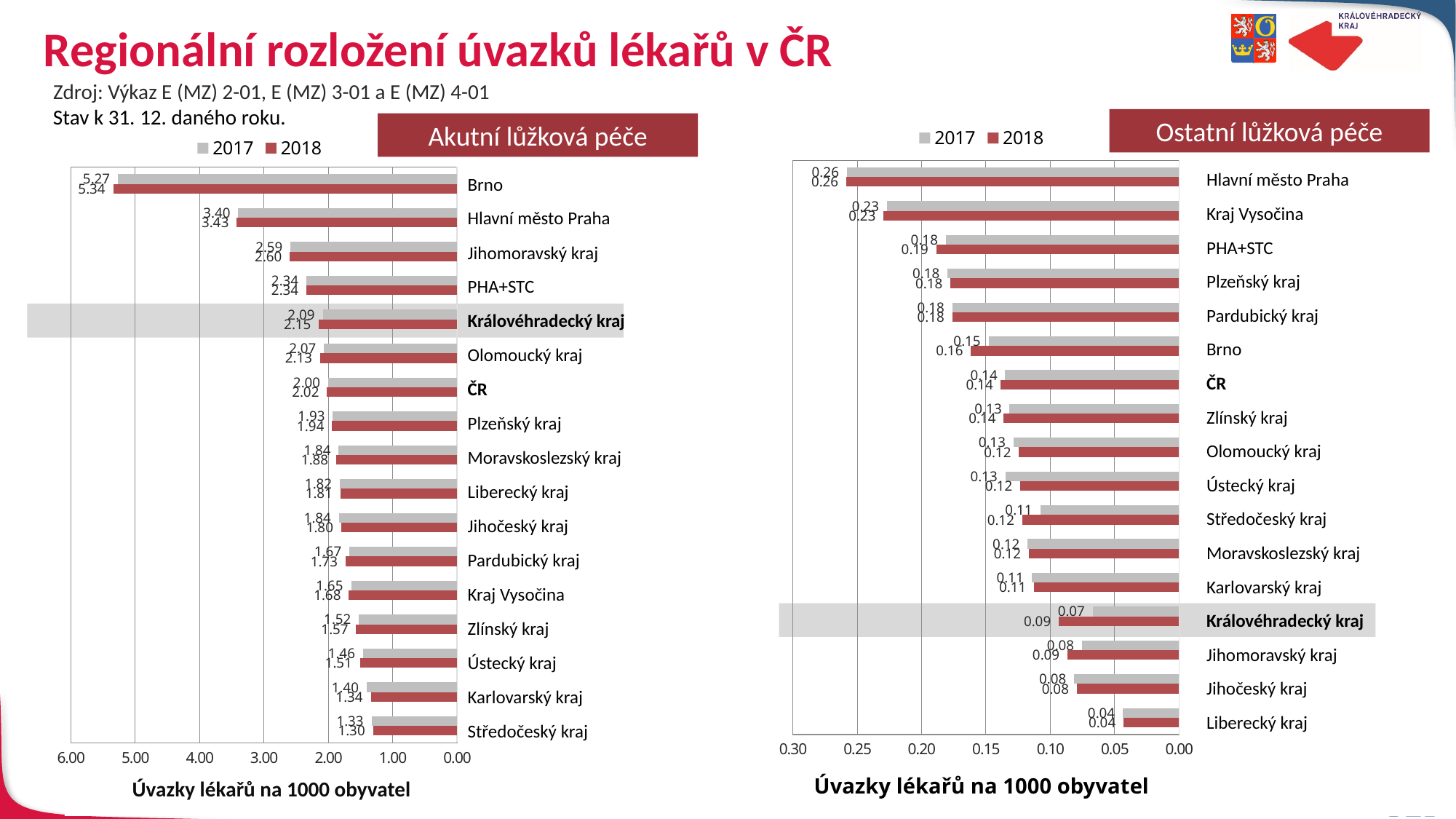
In the 'Akutní lůžková péče' chart, what is the 2018 value for ČR? 2.02 In the 'Akutní lůžková péče' chart, which region has the highest 2018 value? Brno In the 'Akutní lůžková péče' chart, which region has the lowest 2018 value? Středočeský kraj In the 'Akutní lůžková péče' chart, what is the 2018 value for Brno? 5.34 In the 'Akutní lůžková péče' chart, what is the difference between the 2018 values for Brno and Hlavní město Praha? 1.91 In the 'Ostatní lůžková péče' chart, which region has the lowest 2017 value? Liberecký kraj What kind of chart is the 'Ostatní lůžková péče' chart? Bar chart In the 'Ostatní lůžková péče' chart, which is larger: the 2018 value for Hlavní město Praha or the 2018 value for Brno? Hlavní město Praha In the 'Akutní lůžková péče' chart, what is the 2017 value for Královéhradecký kraj? 2.09 In the 'Akutní lůžková péče' chart, how many categories are shown on the vertical axis? 17 In the 'Ostatní lůžková péče' chart, how many series does the legend list? 2 In the 'Ostatní lůžková péče' chart, what is the 2018 value for Královéhradecký kraj? 0.09